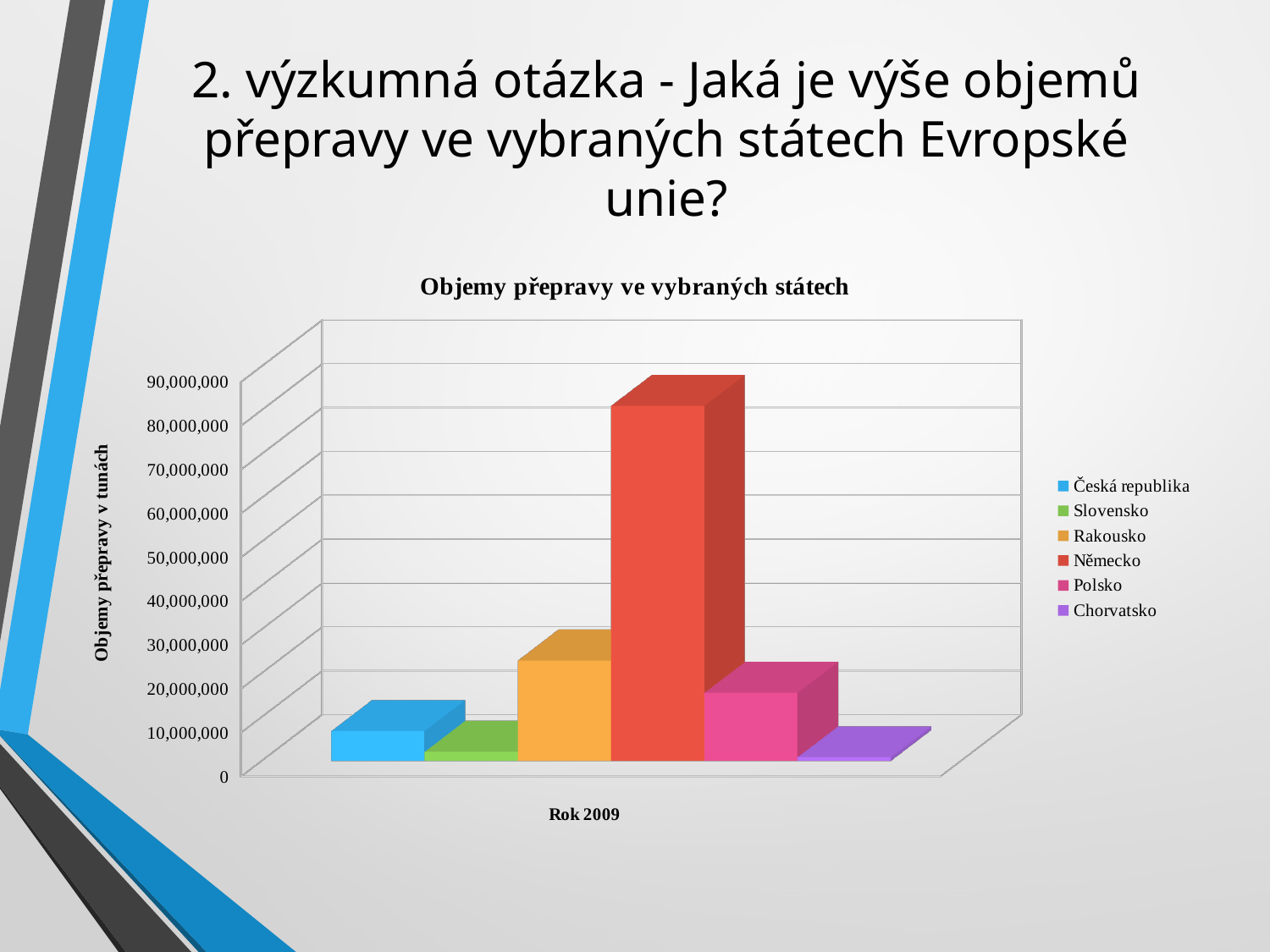
Is the value for Slovensko greater or less than 20,000,000? less Which country has the highest transport volume in the chart? Německo Is the value for Německo greater or less than 70,000,000? greater Which country has the lowest transport volume in the chart? Chorvatsko Which is larger, the value for Česká republika or the value for Slovensko? Česká republika How many series does the chart legend list? 6 What is the title of the chart? Objemy přepravy ve vybraných státech What is the label of the vertical axis of the chart? Objemy přepravy v tunách Is the value for Rakousko greater or less than 40,000,000? less Which is larger, the value for Rakousko or the value for Polsko? Rakousko What type of chart is shown on the slide? bar chart